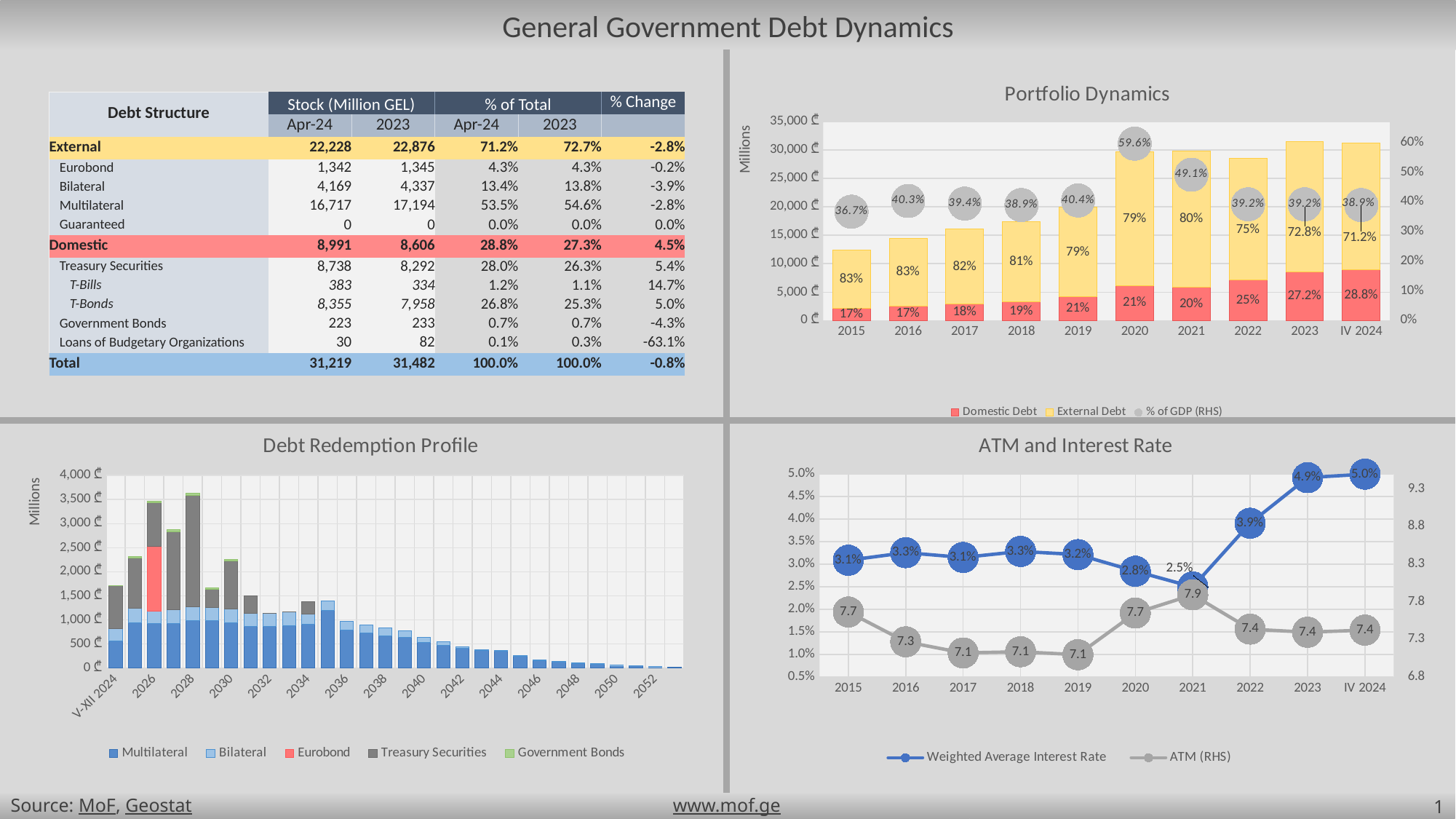
How many series does the legend of the Debt Redemption Profile chart list? 5 In the ATM and Interest Rate chart, by how much is the Weighted Average Interest Rate in IV 2024 higher than in 2015? 1.9% In the Debt Redemption Profile chart, is the total value for 2026 greater or less than 3,000? greater What kind of chart is the ATM and Interest Rate chart? line chart In the Portfolio Dynamics chart, which year has the highest % of GDP value? 2020 In the ATM and Interest Rate chart, what is the ATM value for 2021? 7.9 How many series does the legend of the Portfolio Dynamics chart list? 3 In the ATM and Interest Rate chart, which year has the lowest Weighted Average Interest Rate? 2021 In the Portfolio Dynamics chart, what is the % of GDP value shown for 2020? 59.6% In the ATM and Interest Rate chart, what is the Weighted Average Interest Rate for 2021? 2.5% In the Portfolio Dynamics chart, what is the Domestic Debt share labelled for IV 2024? 28.8% In the Portfolio Dynamics chart, what is the External Debt share labelled for 2015? 83%